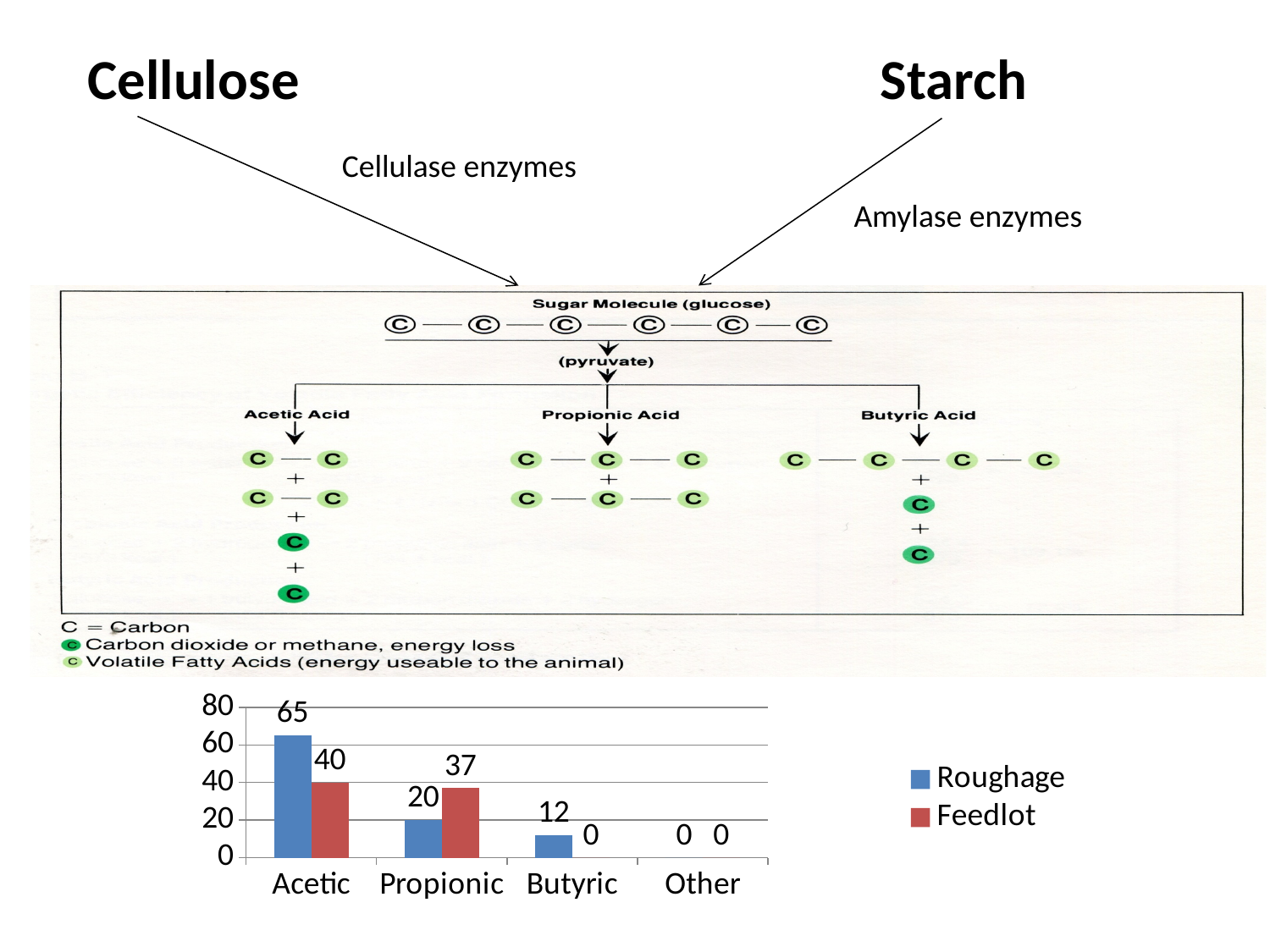
How many series does the legend of the bar chart list? 2 What is the Feedlot value for Propionic in the bar chart? 37 What is the difference between the Feedlot and Roughage values for Propionic in the bar chart? 17 What is the Feedlot value for Butyric in the bar chart? 0 Which category has the highest Feedlot value in the bar chart? Acetic What is the Roughage value for Acetic in the bar chart? 65 In the bar chart, which is larger for Propionic: Roughage or Feedlot? Feedlot What colour are the Feedlot bars in the bar chart? red Which category has the highest Roughage value in the bar chart? Acetic What kind of chart is shown at the bottom of the slide? bar chart How many categories are shown on the x axis of the bar chart? 4 What is the difference between the Roughage and Feedlot values for Acetic in the bar chart? 25